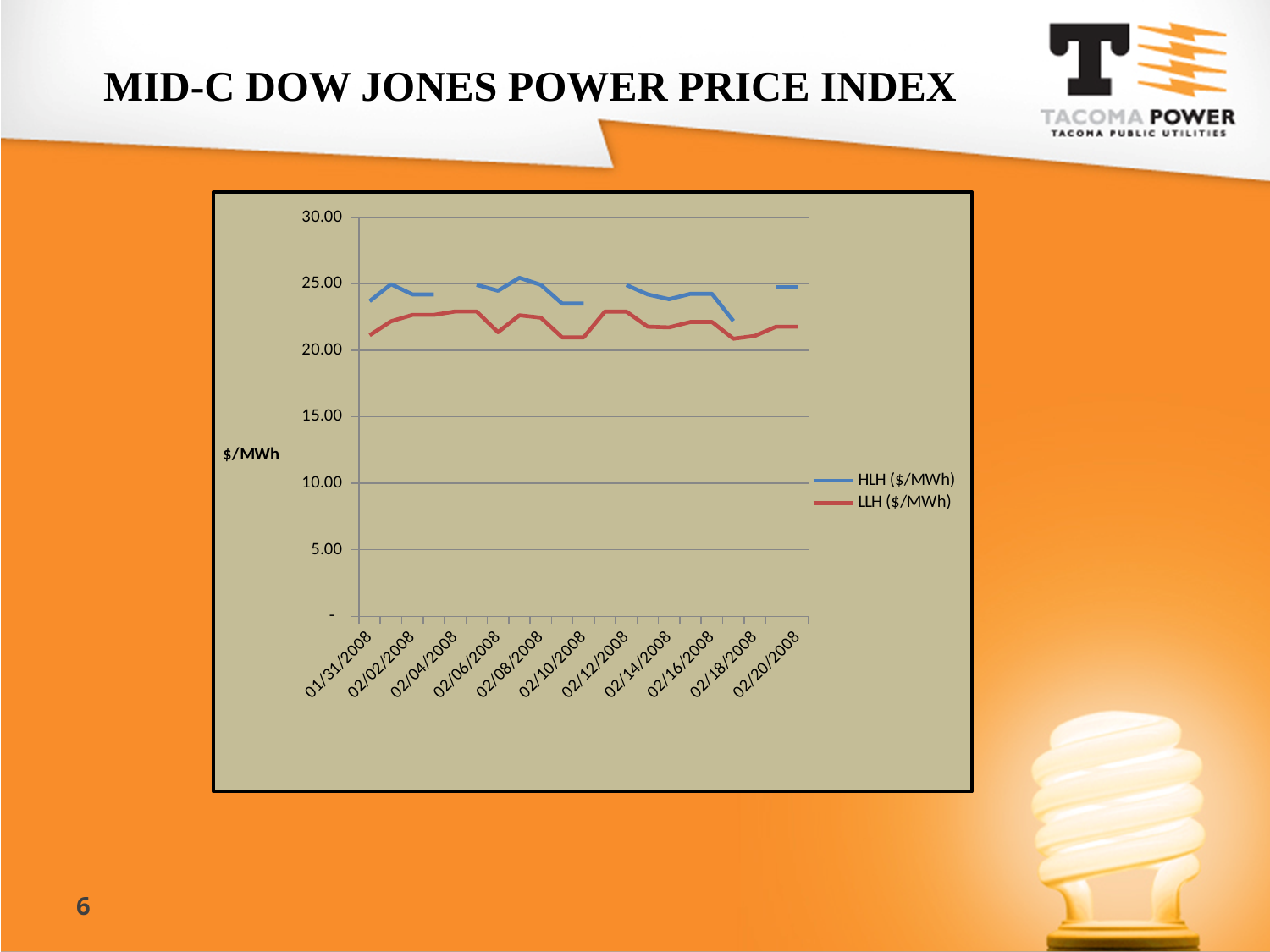
What kind of chart is shown on the slide? line chart How many series does the chart legend list? 2 Is the HLH ($/MWh) value on 01/31/2008 greater or less than 20.00? greater Does the HLH ($/MWh) line rise or fall between 02/16/2008 and 02/18/2008? fall What is the label on the vertical axis of the chart? $/MWh Is the HLH ($/MWh) value on 02/18/2008 greater or less than 25.00? less How many dates are labeled on the x axis of the chart? 11 Which series reaches the highest value on the chart? HLH ($/MWh) Which series is plotted higher across the chart, HLH ($/MWh) or LLH ($/MWh)? HLH ($/MWh) Is the LLH ($/MWh) value on 02/04/2008 greater or less than 25.00? less What are the two series named in the chart legend? HLH ($/MWh) and LLH ($/MWh)